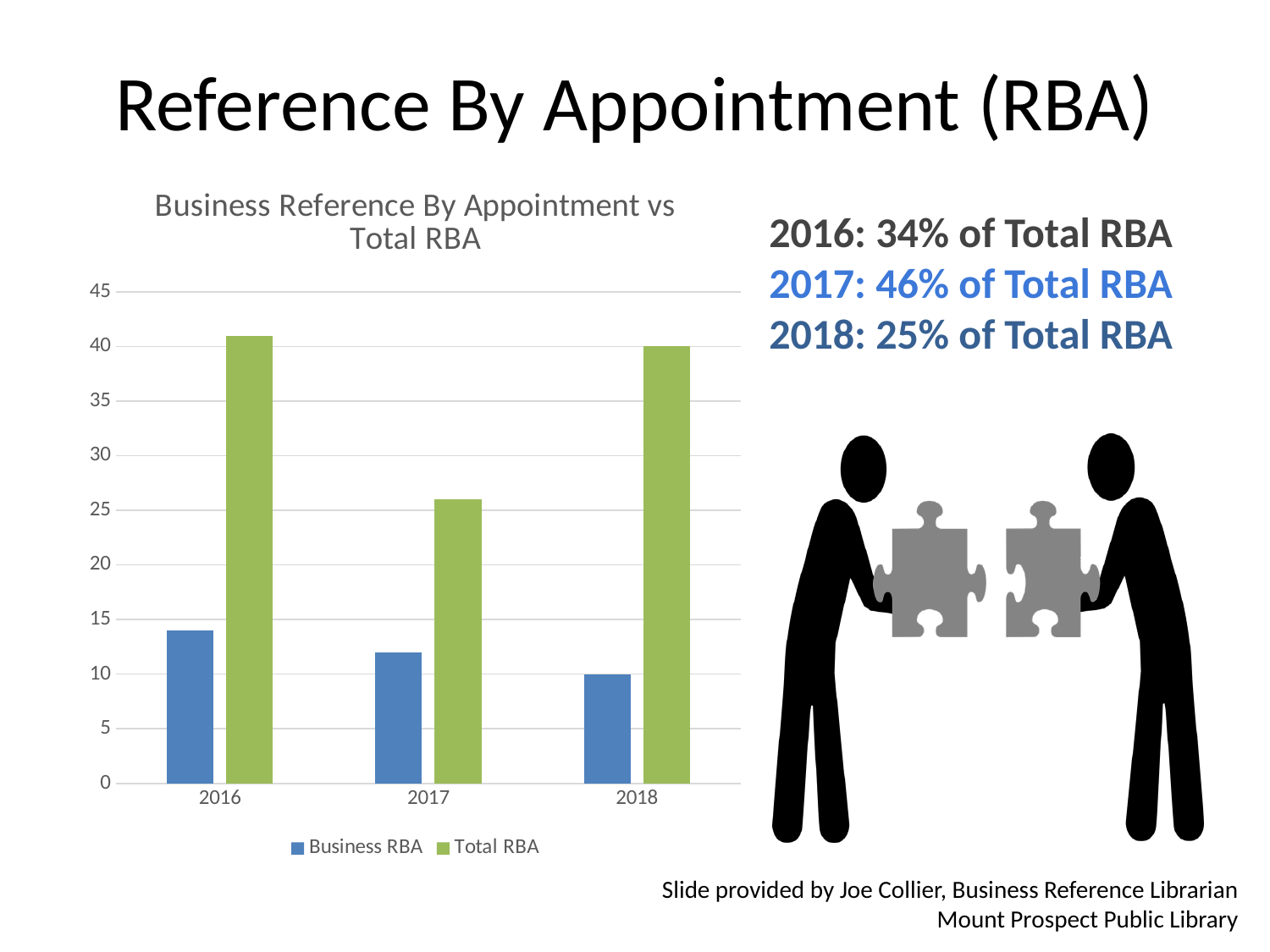
What kind of chart is shown on the slide? bar chart Is the Business RBA value for 2016 greater or less than 10? greater What is the title of the chart? Business Reference By Appointment vs Total RBA Is the Total RBA value for 2017 greater or less than 30? less How many years are shown on the x axis of the chart? 3 In which year is Total RBA lowest? 2017 Does Business RBA rise or fall from 2016 to 2018? fall Which series is shown in green in the chart? Total RBA Which is larger: Total RBA in 2017 or Business RBA in 2016? Total RBA in 2017 In which year is Business RBA lowest? 2018 Is the Total RBA value for 2016 greater or less than 35? greater How many series does the chart legend list? 2